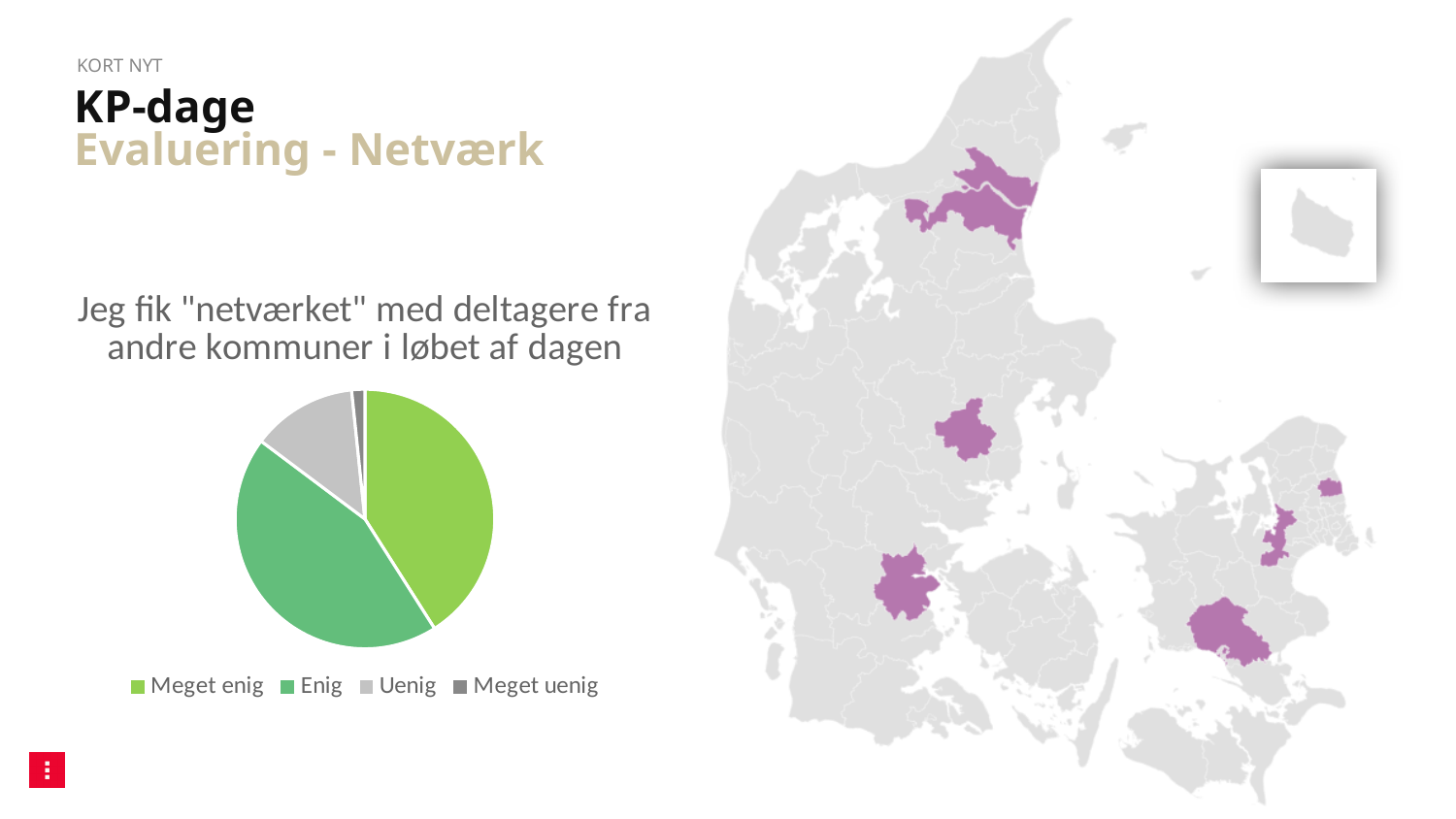
How many categories does the pie chart's legend list? 4 Which legend entry in the pie chart is shown in light green? Meget enig What kind of chart is shown on the slide? pie chart Which slice is larger in the pie chart, Enig or Meget uenig? Enig What is the title of the pie chart? Jeg fik "netværket" med deltagere fra andre kommuner i løbet af dagen Which category has the smallest slice in the pie chart? Meget uenig Which slice is larger in the pie chart, Meget enig or Uenig? Meget enig Which slice is larger in the pie chart, Uenig or Meget uenig? Uenig